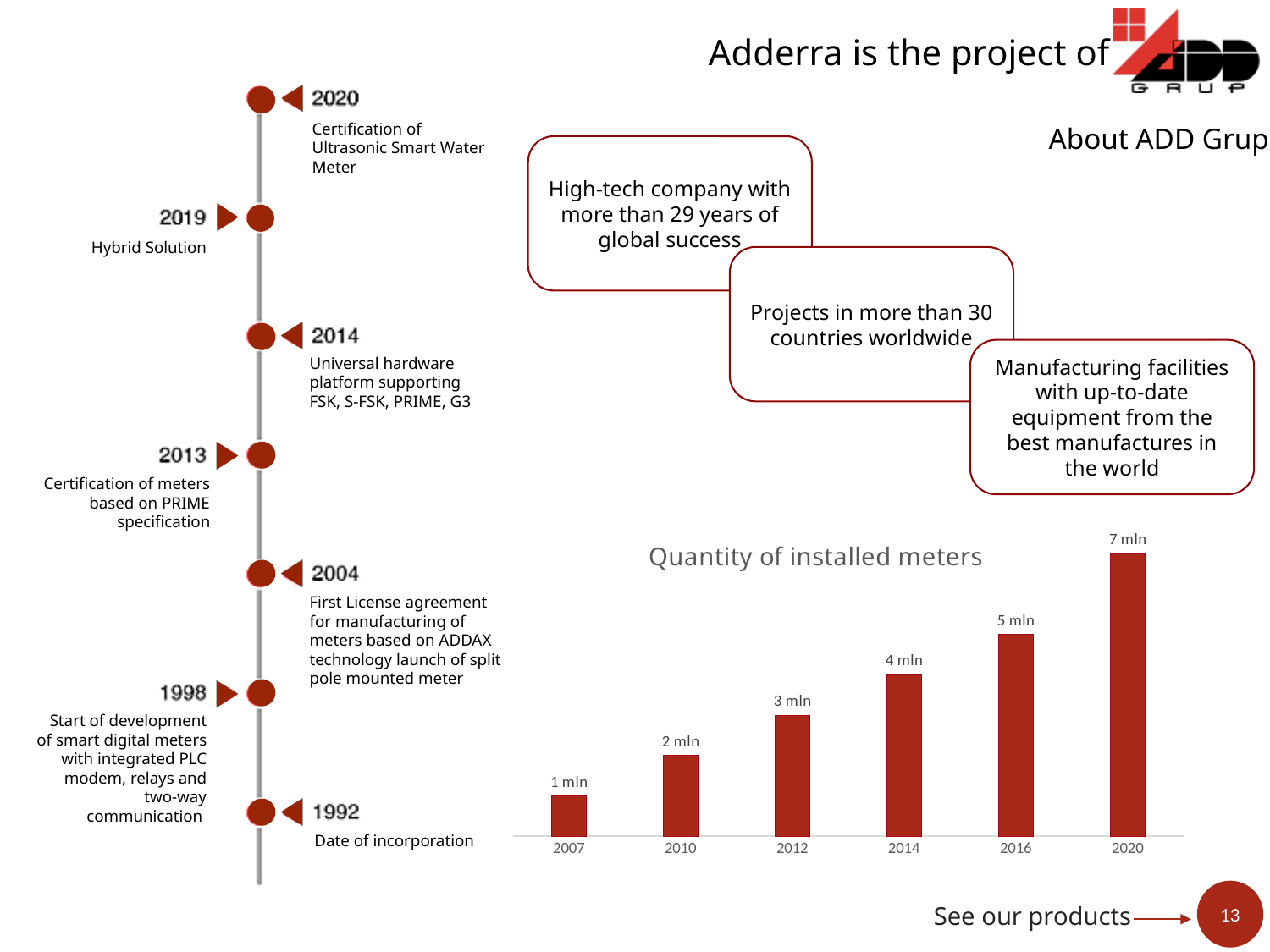
What is the difference in installed meters between 2014 and 2010? 2 mln What is the difference in installed meters between 2020 and 2016? 2 mln Which year has more installed meters, 2012 or 2016? 2016 Do the values in the chart rise or fall from 2007 to 2020? Rise What is the title of the chart on the slide? Quantity of installed meters What kind of chart is used to show the quantity of installed meters? Bar chart Which year has the lowest quantity of installed meters? 2007 How many years are shown on the x axis of the chart? 6 Which year has the highest quantity of installed meters? 2020 What is the quantity of installed meters in 2007? 1 mln What is the quantity of installed meters in 2020? 7 mln What is the quantity of installed meters in 2014? 4 mln